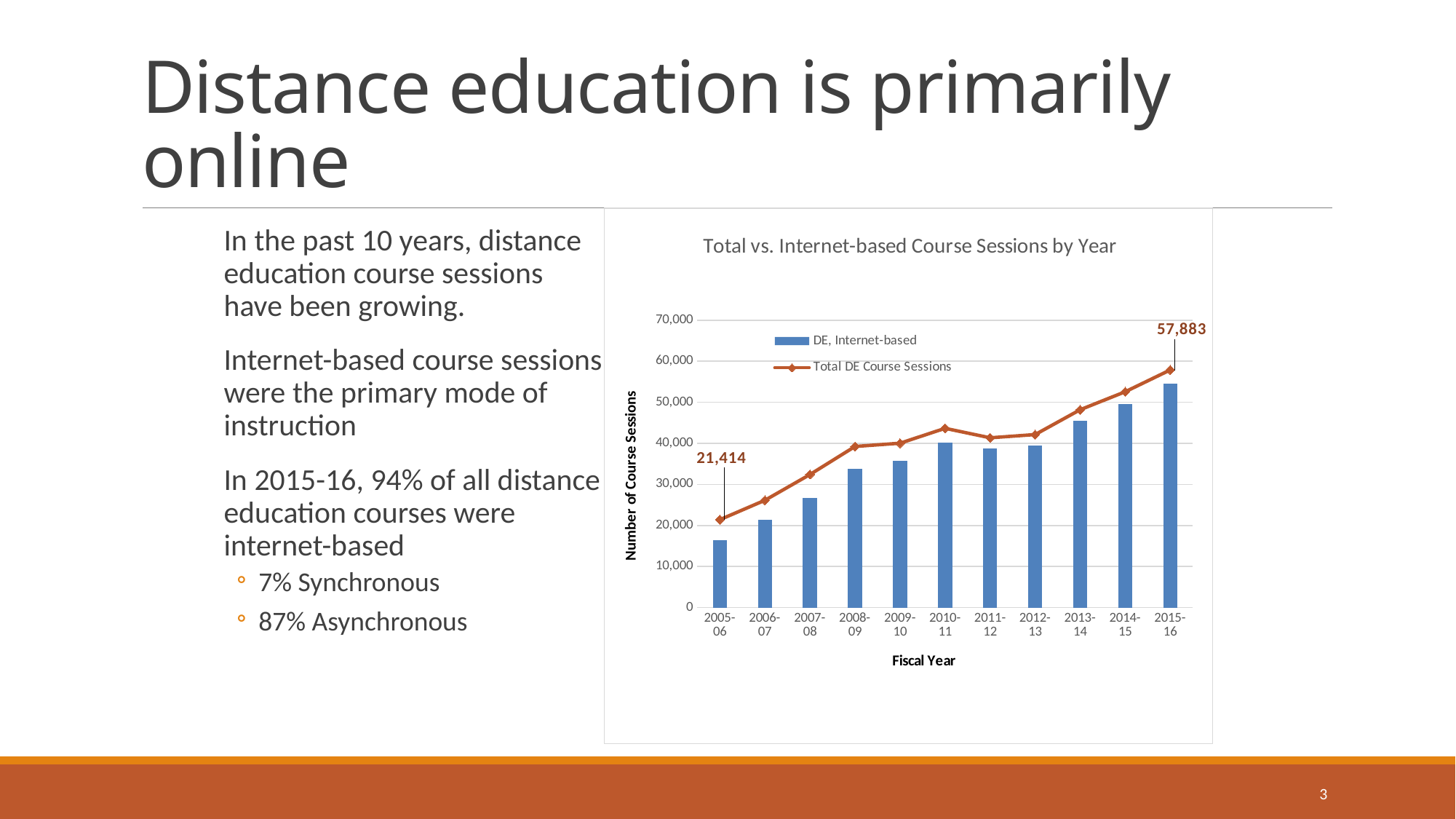
What is the value of Total DE Course Sessions for 2005-06? 21,414 Do the Total DE Course Sessions generally rise or fall from 2005-06 to 2015-16? Rise Which fiscal year has the lowest Total DE Course Sessions? 2005-06 How many fiscal years are shown on the x axis? 11 Is the value for DE, Internet-based in 2015-16 greater or less than 50,000? greater What kind of chart is shown on the slide? Combined bar and line chart Is the value for DE, Internet-based in 2013-14 greater or less than 40,000? greater What is the value of Total DE Course Sessions for 2015-16? 57,883 Is the value for DE, Internet-based in 2005-06 greater or less than 20,000? less What is the difference between Total DE Course Sessions in 2015-16 and 2005-06? 36,469 How many series does the legend list? 2 Which fiscal year has the highest number of DE, Internet-based course sessions? 2015-16